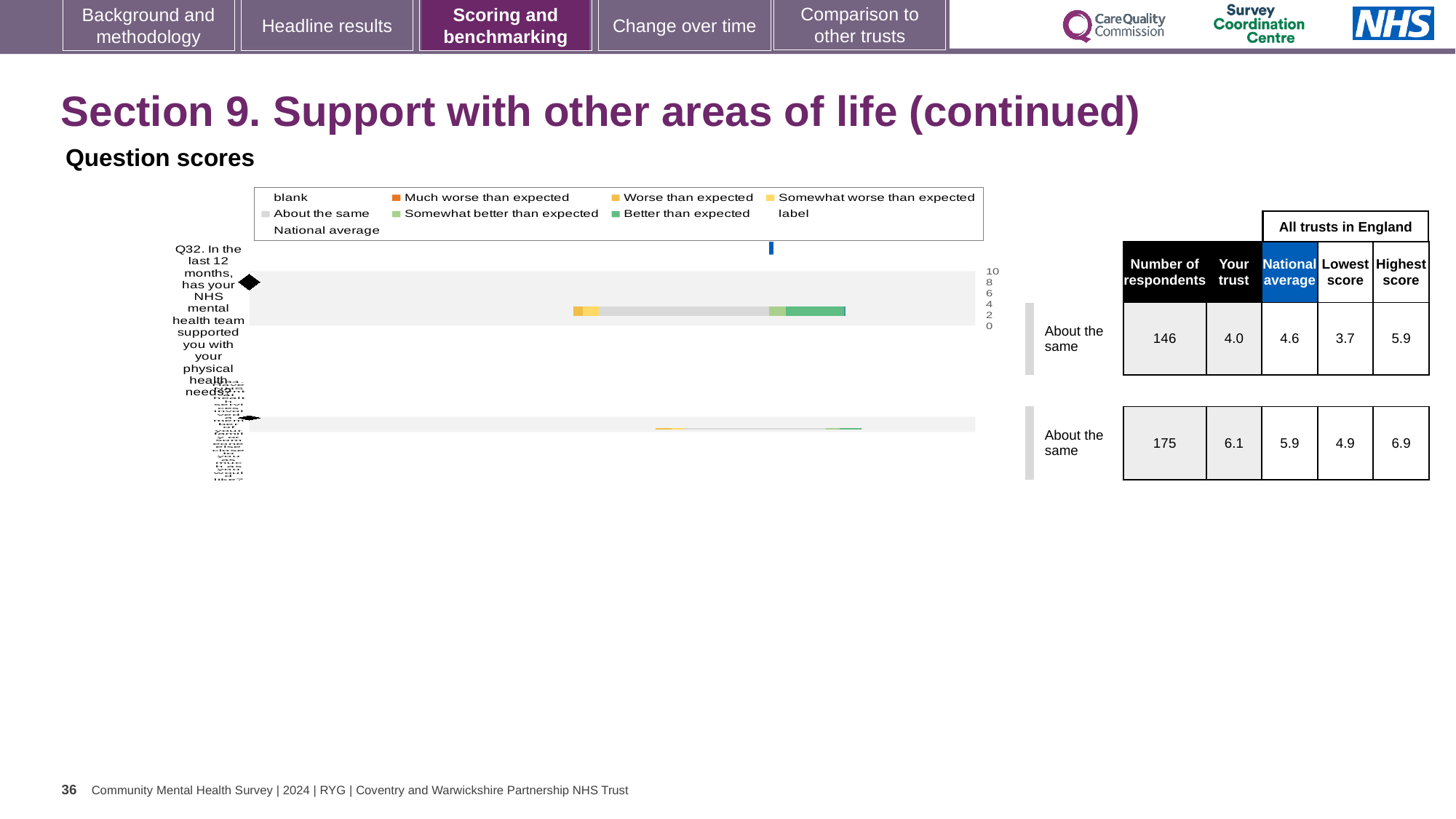
Which is larger for Q32: the trust's score or the national average? National average How many respondents answered Q32? 146 What type of chart is shown under 'Question scores'? bar chart What benchmark category is Q32 assigned to? About the same What colour represents 'Much worse than expected' in the legend? Orange What colour represents 'Better than expected' in the legend? Green What is the lowest score among all trusts in England for Q32? 3.7 What is the difference between the national average and the trust's score for Q32? 0.6 What is the highest score among all trusts in England for Q32? 5.9 How many question rows are plotted in the chart? 2 What is the 'Your trust' score for Q32 (support with physical health needs)? 4.0 What is the national average score for Q32? 4.6